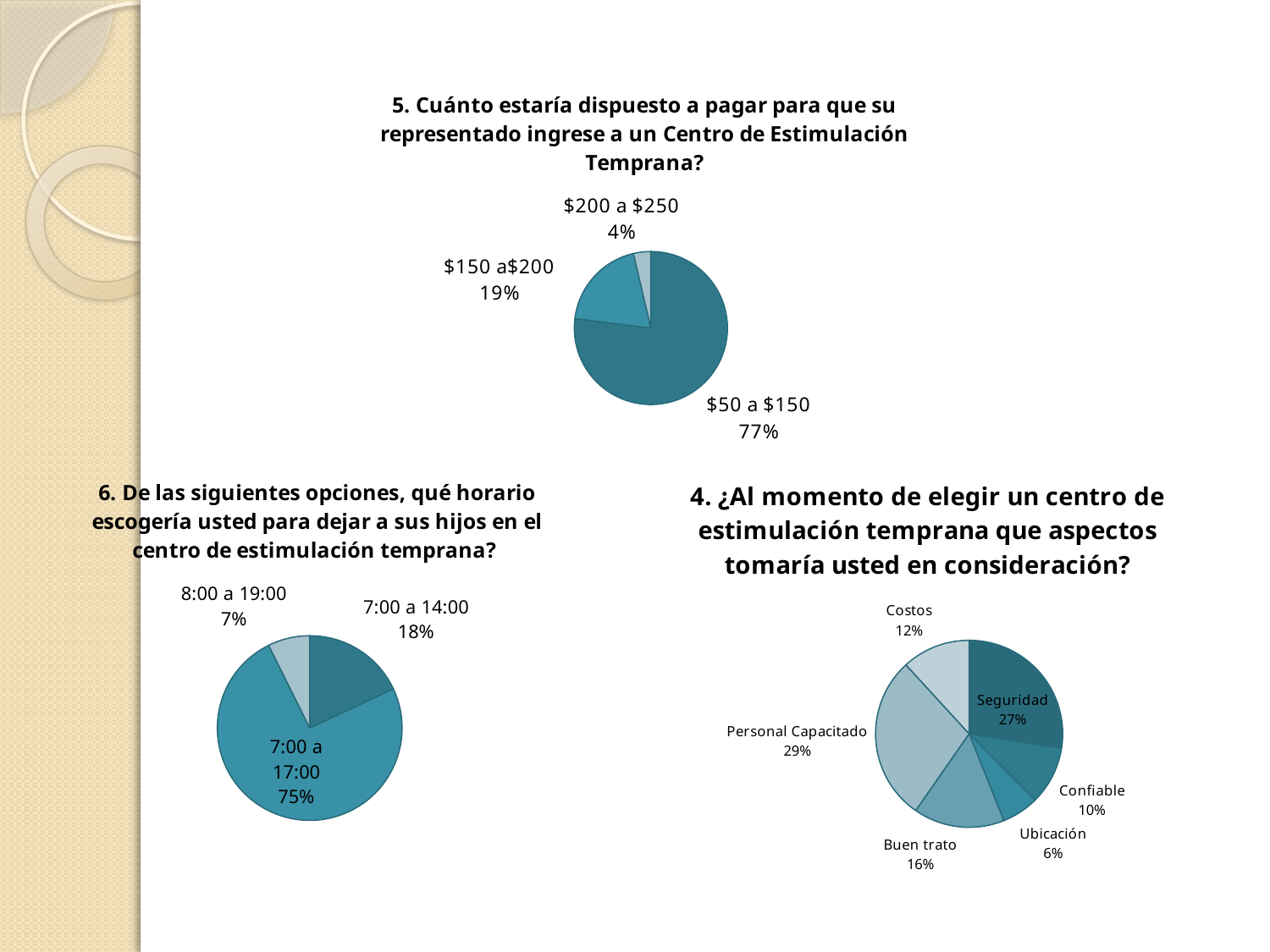
In the top pie chart (question 5, how much would you pay), what share is '$50 a $150'? 77% In the bottom-right pie chart (question 4, aspects considered), what share is 'Buen trato'? 16% In the top pie chart (question 5), which category has the smallest share? $200 a $250 In the top pie chart (question 5), how many slices does the pie have? 3 In the bottom-left pie chart (question 6), which schedule option has the largest share? 7:00 a 17:00 In the bottom-right pie chart (question 4), which aspect has the smallest share? Ubicación In the bottom-right pie chart (question 4), which aspect has the largest share? Personal Capacitado In the bottom-right pie chart (question 4), how many categories are shown? 6 In the bottom-left pie chart (question 6, schedule), what share is '7:00 a 14:00'? 18% In the top pie chart (question 5), what is the difference between the '$50 a $150' share and the '$150 a$200' share? 58% What type of chart is used for question 4 (bottom right)? Pie chart In the bottom-left pie chart (question 6), which is larger: '8:00 a 19:00' or '7:00 a 14:00'? 7:00 a 14:00